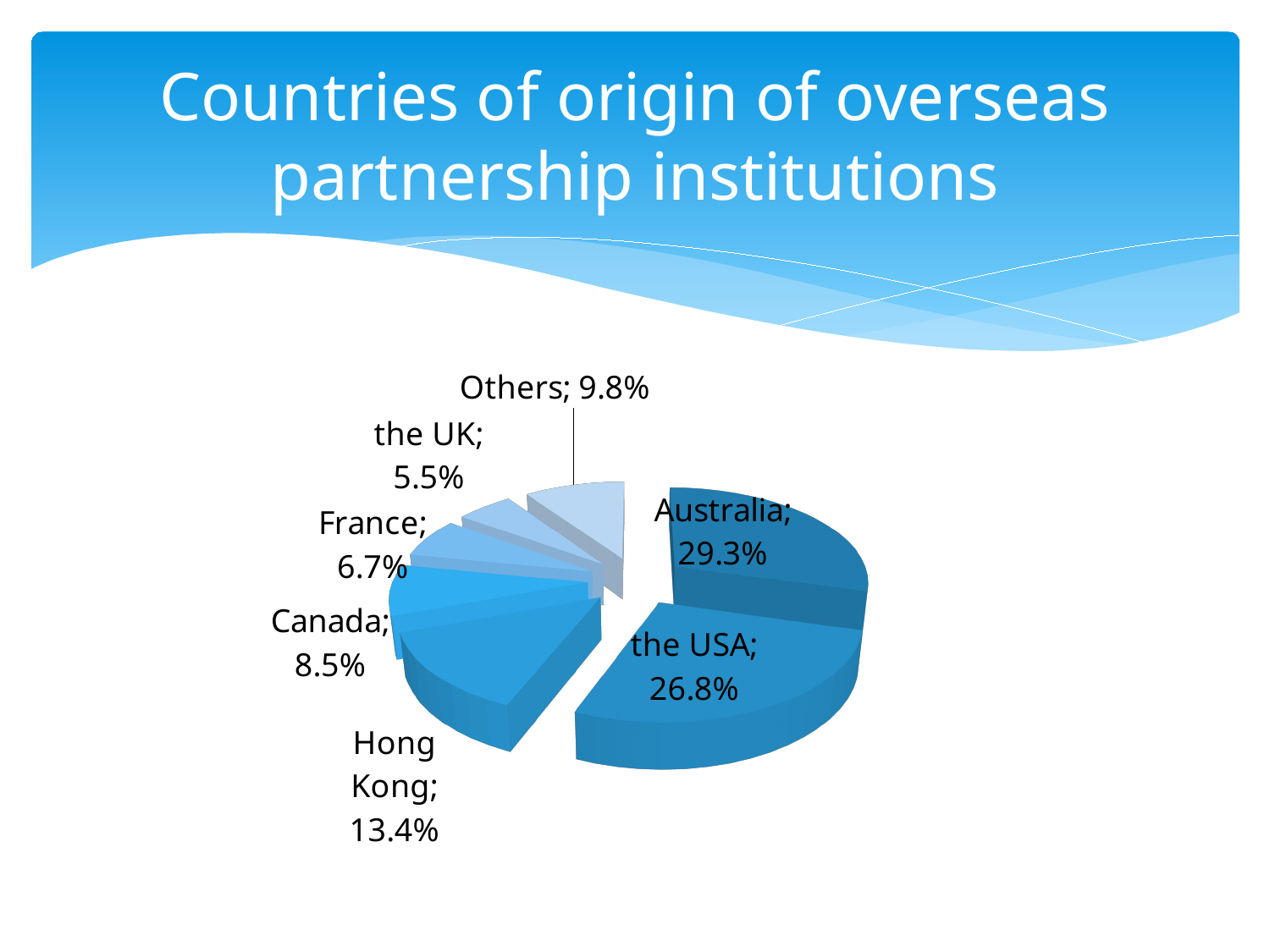
How many slices does the pie chart have? 7 Which country has the largest share of overseas partnership institutions? Australia What share of overseas partnership institutions comes from Australia? 29.3% Which category has the smallest share in the pie chart? the UK Which has a larger share, France or Canada? Canada What percentage is shown for Others? 9.8% What is the difference in percentage points between Hong Kong and Canada? 4.9 What kind of chart is shown on the slide? pie chart What is the title of the slide containing the pie chart? Countries of origin of overseas partnership institutions What is the difference in percentage points between Australia and the USA? 2.5 What percentage is shown for Hong Kong? 13.4% What percentage is shown for the UK? 5.5%